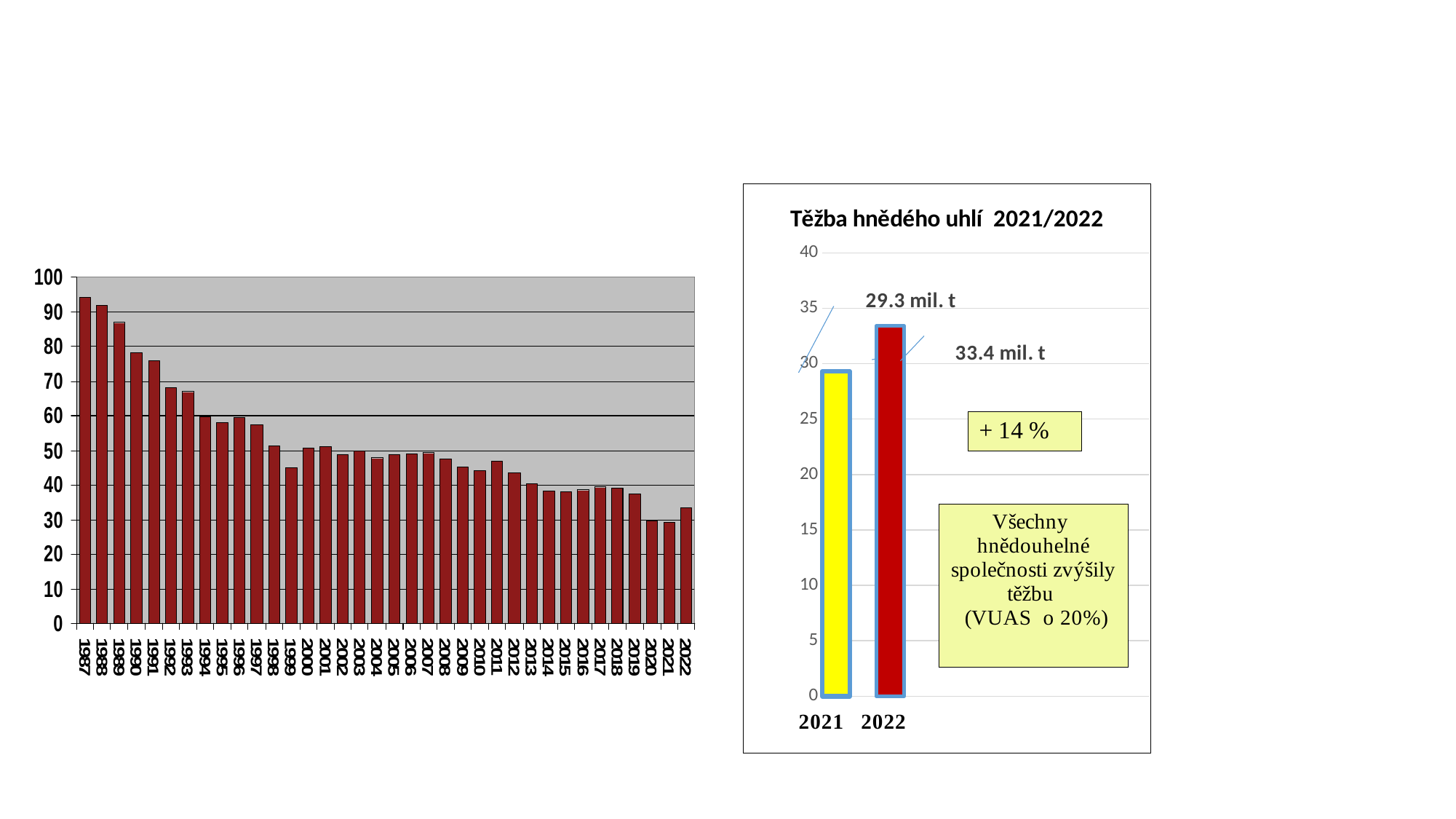
In the large chart on the left of the slide, how many years are plotted on the x axis? 36 In the large chart on the left of the slide, is the value for 1987 greater or less than 90? greater In the chart titled 'Těžba hnědého uhlí 2021/2022', what is the value for 2022? 33.4 mil. t In the chart titled 'Těžba hnědého uhlí 2021/2022', how many bars are plotted? 2 What kind of chart is the large chart on the left of the slide? Bar chart In the large chart on the left of the slide, which year has the highest value? 1987 In the chart titled 'Těžba hnědého uhlí 2021/2022', what colour is the bar for 2021? Yellow In the large chart on the left of the slide, do the values generally rise or fall from 1987 to 2022? Fall In the chart titled 'Těžba hnědého uhlí 2021/2022', what is the value for 2021? 29.3 mil. t In the chart titled 'Těžba hnědého uhlí 2021/2022', what percentage change is shown in the box next to the bars? + 14 % In the chart titled 'Těžba hnědého uhlí 2021/2022', what is the difference between the 2022 and 2021 values? 4.1 mil. t In the chart titled 'Těžba hnědého uhlí 2021/2022', which year has the larger value, 2021 or 2022? 2022